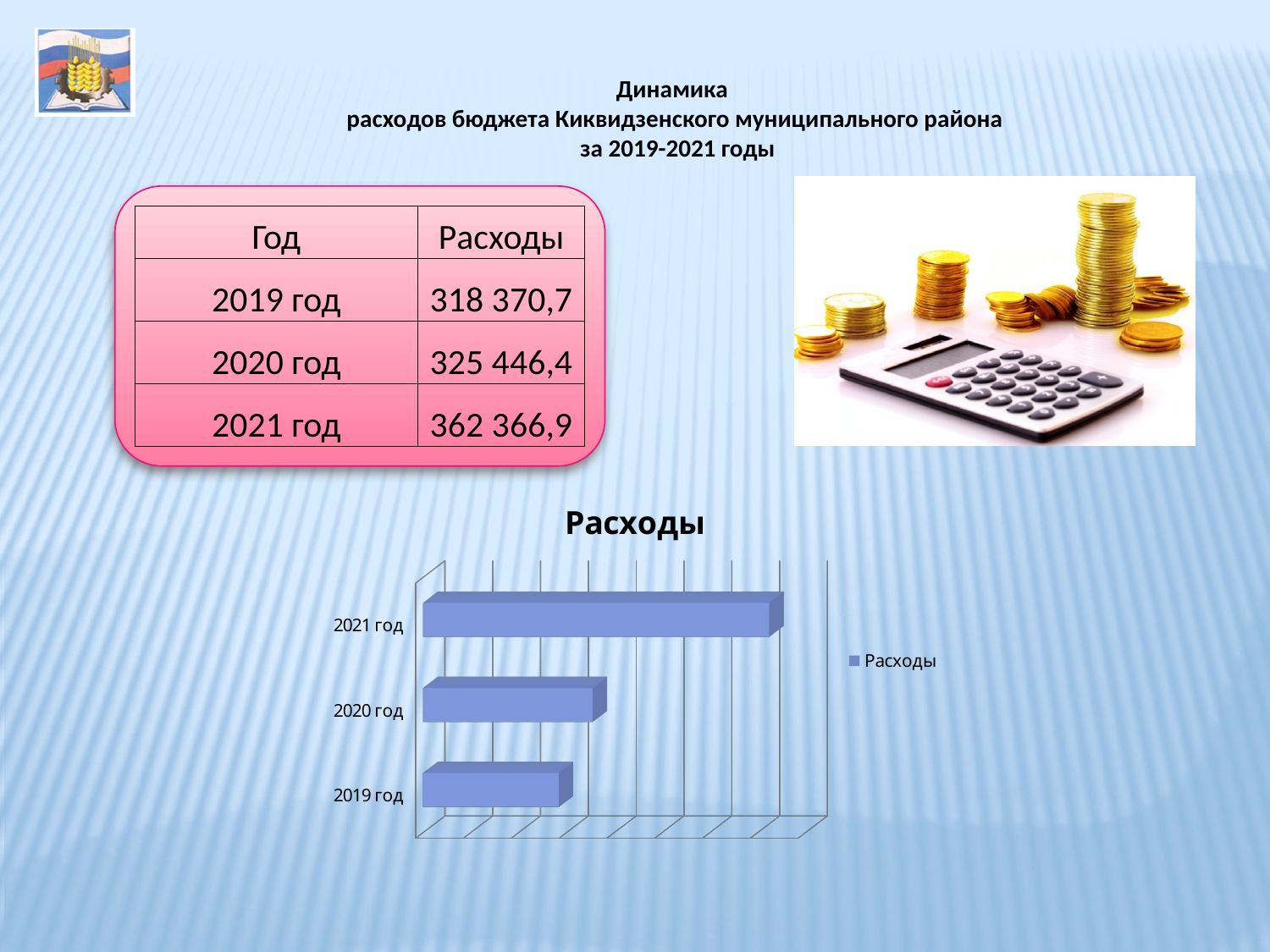
What is the difference between the Расходы for 2021 год and 2020 год? 36 920,5 Which year has the shortest bar in the chart? 2019 год What is the value of Расходы for 2021 год? 362 366,9 What kind of chart is shown on the slide? bar chart How many categories (years) are plotted in the chart? 3 Which year has the longest bar in the chart? 2021 год Which is larger, the value for 2020 год or for 2019 год? 2020 год What is the title of the chart? Расходы What is the name of the series shown in the chart legend? Расходы What is the value of Расходы for 2019 год? 318 370,7 How many series does the chart legend list? 1 Do the expenditures rise or fall from 2019 to 2021? rise